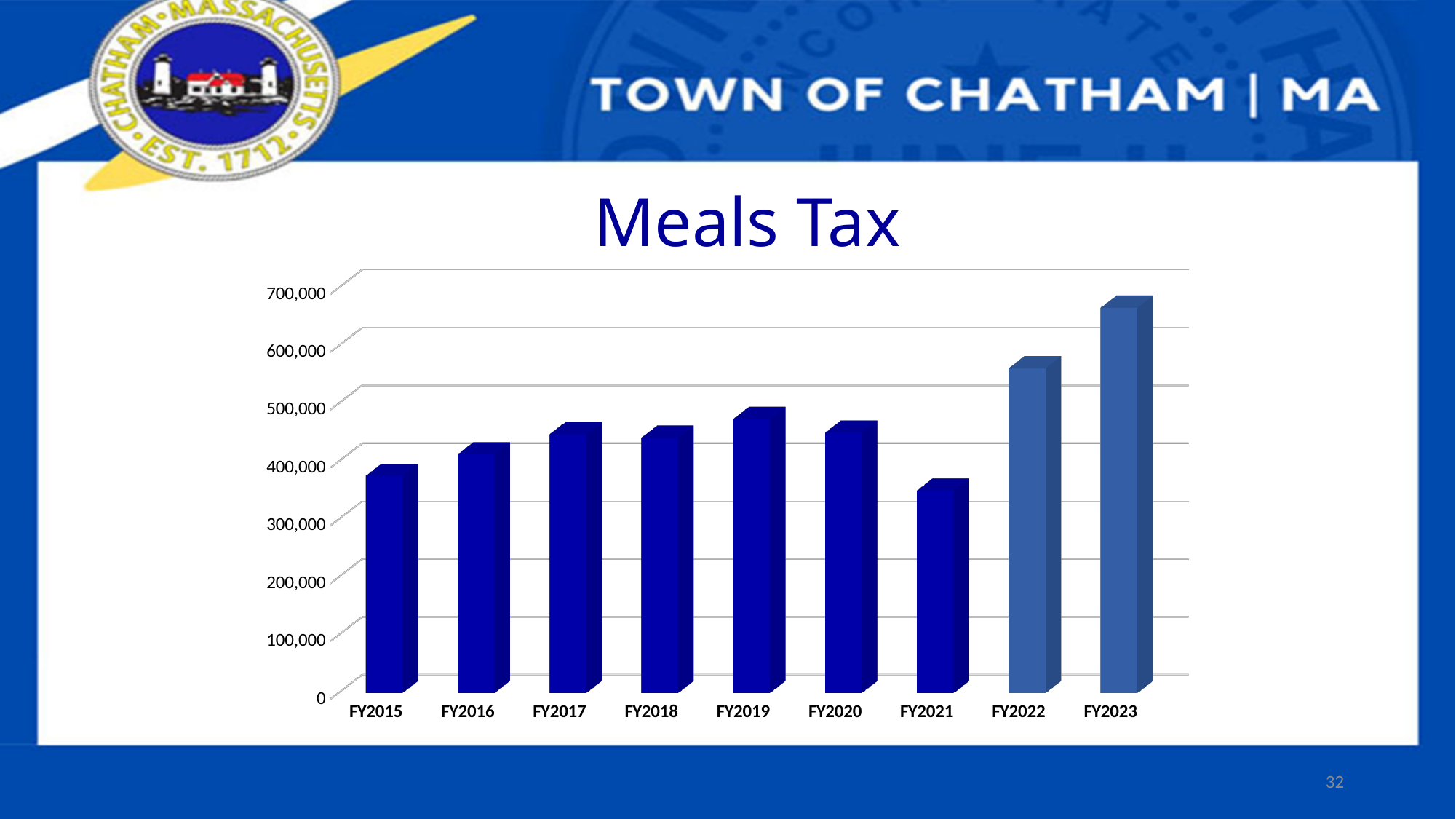
Is the value for FY2023 greater or less than 600,000? greater Is the value for FY2022 greater or less than 500,000? greater Which fiscal year has the highest meals tax value? FY2023 Do the values rise or fall from FY2021 to FY2023? rise Is the value for FY2019 greater or less than 500,000? less How many fiscal years are shown on the x axis of the chart? 9 What is the title of the chart? Meals Tax Which fiscal year has the lowest meals tax value? FY2021 What kind of chart is shown on the slide? bar chart Which is larger, the value for FY2022 or the value for FY2019? FY2022